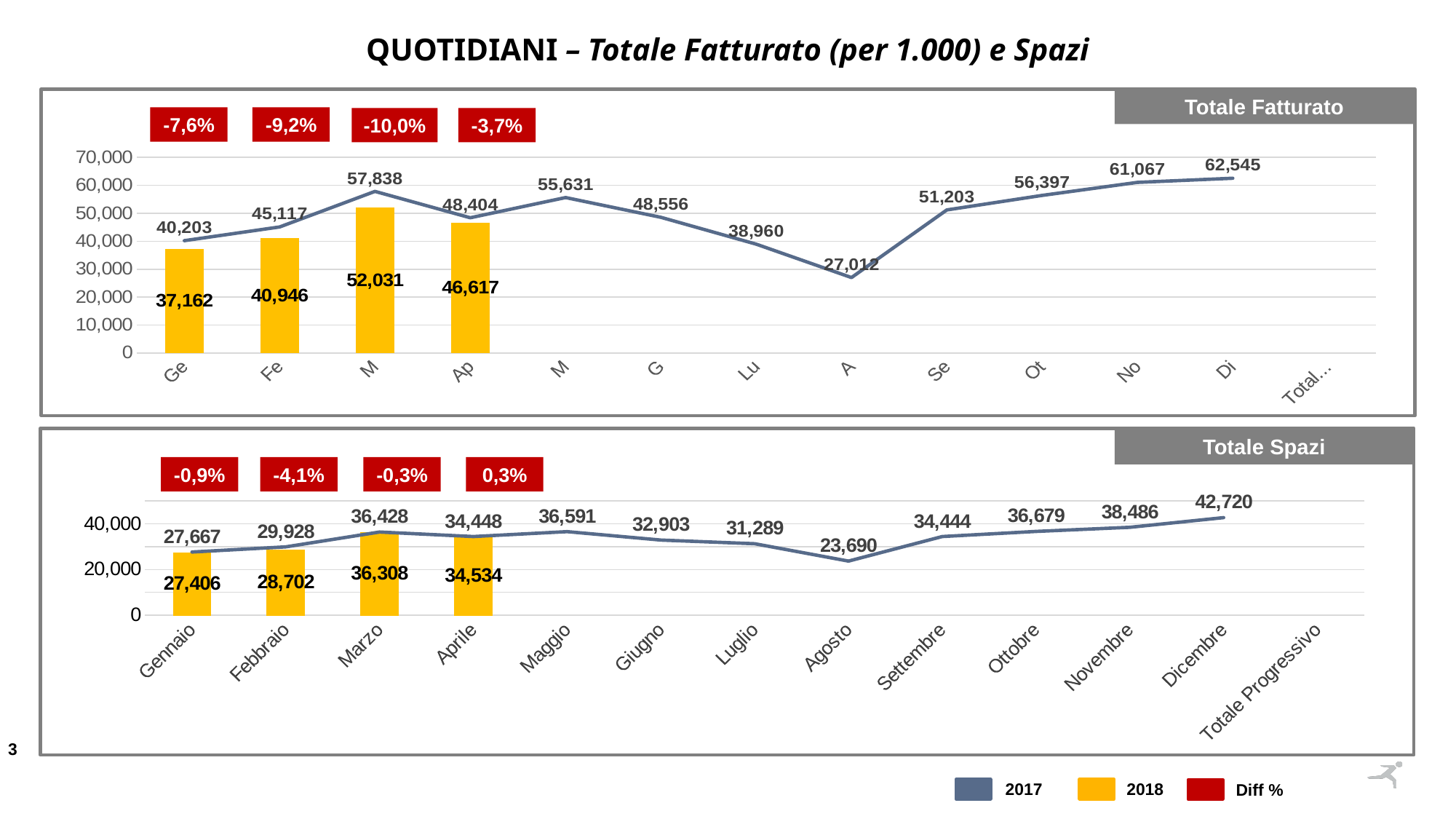
In the Totale Fatturato chart, what is the difference between the 2017 and 2018 values for Ap (April)? 1,787 In the Totale Spazi chart, which colour represents the 2018 series? Yellow/orange In the Totale Fatturato chart, what is the 2017 value for M (March)? 57,838 In the Totale Fatturato chart, what is the Diff % shown for Fe (February)? -9,2% In the Totale Spazi chart, what is the 2017 value for Agosto? 23,690 In the Totale Fatturato chart, which month has the lowest 2017 value? A (August), 27,012 In the Totale Spazi chart, which is larger: the 2017 value for Aprile or the 2018 value for Aprile? 2018 (34,534) In the Totale Fatturato chart, which month has the highest 2017 value? Di (December), 62,545 In the Totale Spazi chart, what is the 2018 value for Marzo? 36,308 In the Totale Fatturato chart, what is the 2018 value for Ge (January)? 37,162 How many series does the legend at the bottom of the slide list? 3 In the Totale Spazi chart, what is the Diff % shown for Aprile? 0,3%